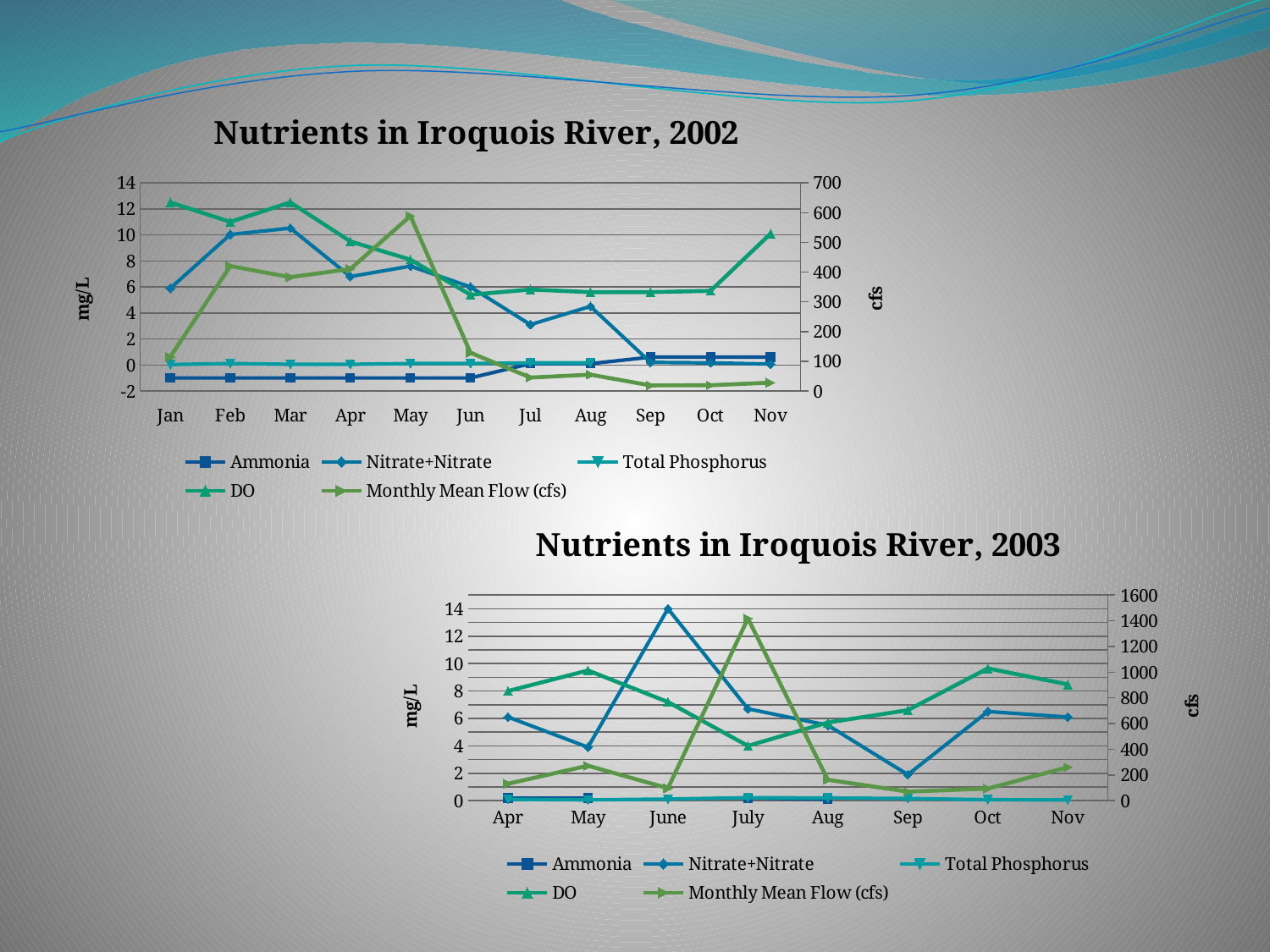
What is the label of the right-hand vertical axis in 'Nutrients in Iroquois River, 2002'? cfs In 'Nutrients in Iroquois River, 2003', in which month is Monthly Mean Flow (cfs) highest? July In 'Nutrients in Iroquois River, 2003', in which month is Nitrate+Nitrate highest? June How many months are shown on the x axis of 'Nutrients in Iroquois River, 2002'? 11 In 'Nutrients in Iroquois River, 2003', which is larger: Nitrate+Nitrate in June or Nitrate+Nitrate in July? June In 'Nutrients in Iroquois River, 2002', is the Nitrate+Nitrate value for Sep greater or less than 2? less In 'Nutrients in Iroquois River, 2002', in which month is Monthly Mean Flow (cfs) highest? May How many months are shown on the x axis of 'Nutrients in Iroquois River, 2003'? 8 In 'Nutrients in Iroquois River, 2002', is the DO value for Jan greater or less than 10? greater How many series does the legend of 'Nutrients in Iroquois River, 2003' list? 5 In 'Nutrients in Iroquois River, 2003', is the Monthly Mean Flow (cfs) value for July greater or less than 1200? greater What type of chart is 'Nutrients in Iroquois River, 2002'? Line chart